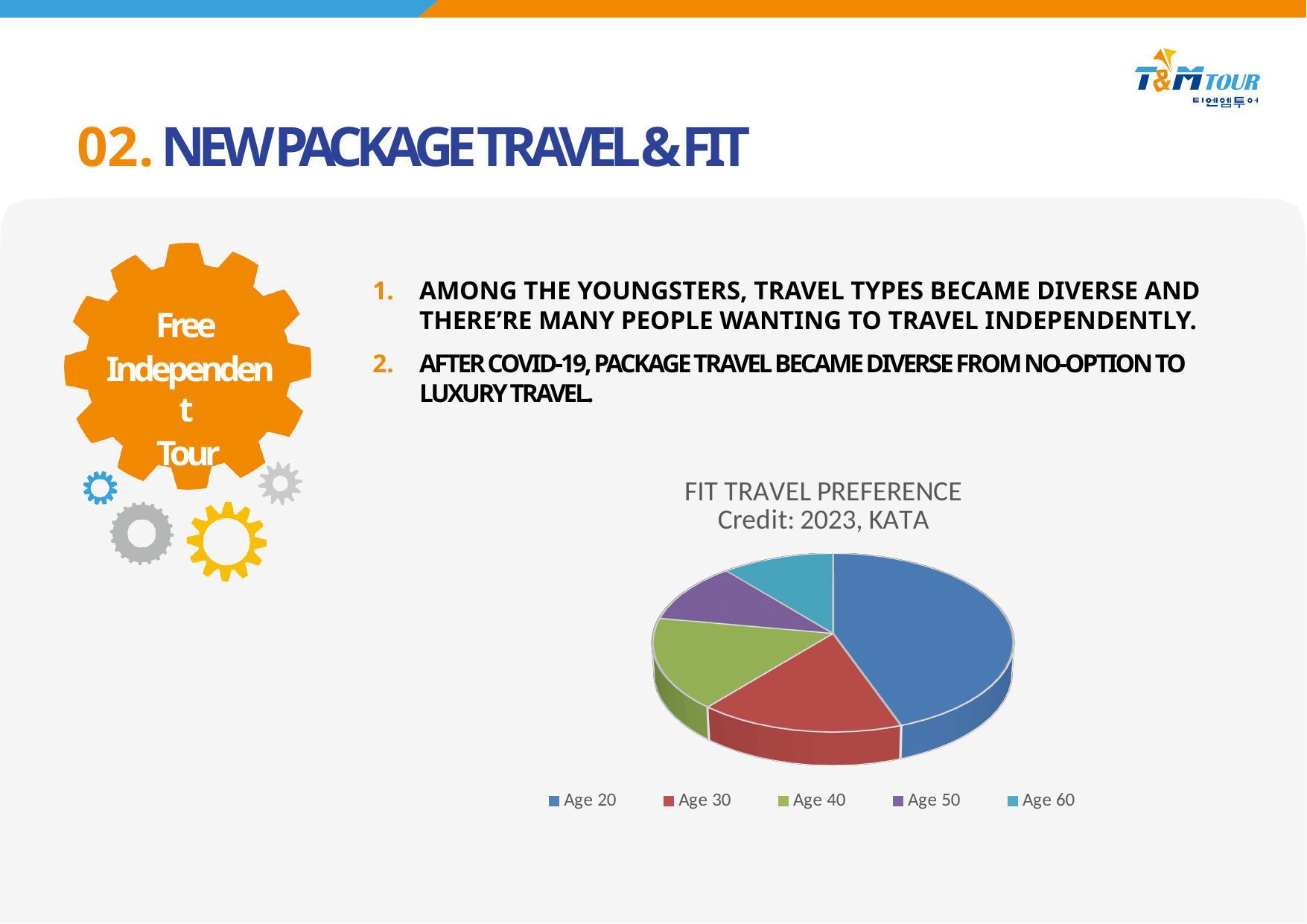
What kind of chart is shown on the slide? Pie chart What is the title of the chart? FIT TRAVEL PREFERENCE Which slice is larger, Age 20 or Age 60? Age 20 Which age group has the largest slice of the pie chart? Age 20 Which slice is larger, Age 30 or Age 50? Age 30 How many categories does the pie chart show? 5 How many entries does the chart legend list? 5 What source credit is given under the chart title? Credit: 2023, KATA Which slice is larger, Age 20 or Age 30? Age 20